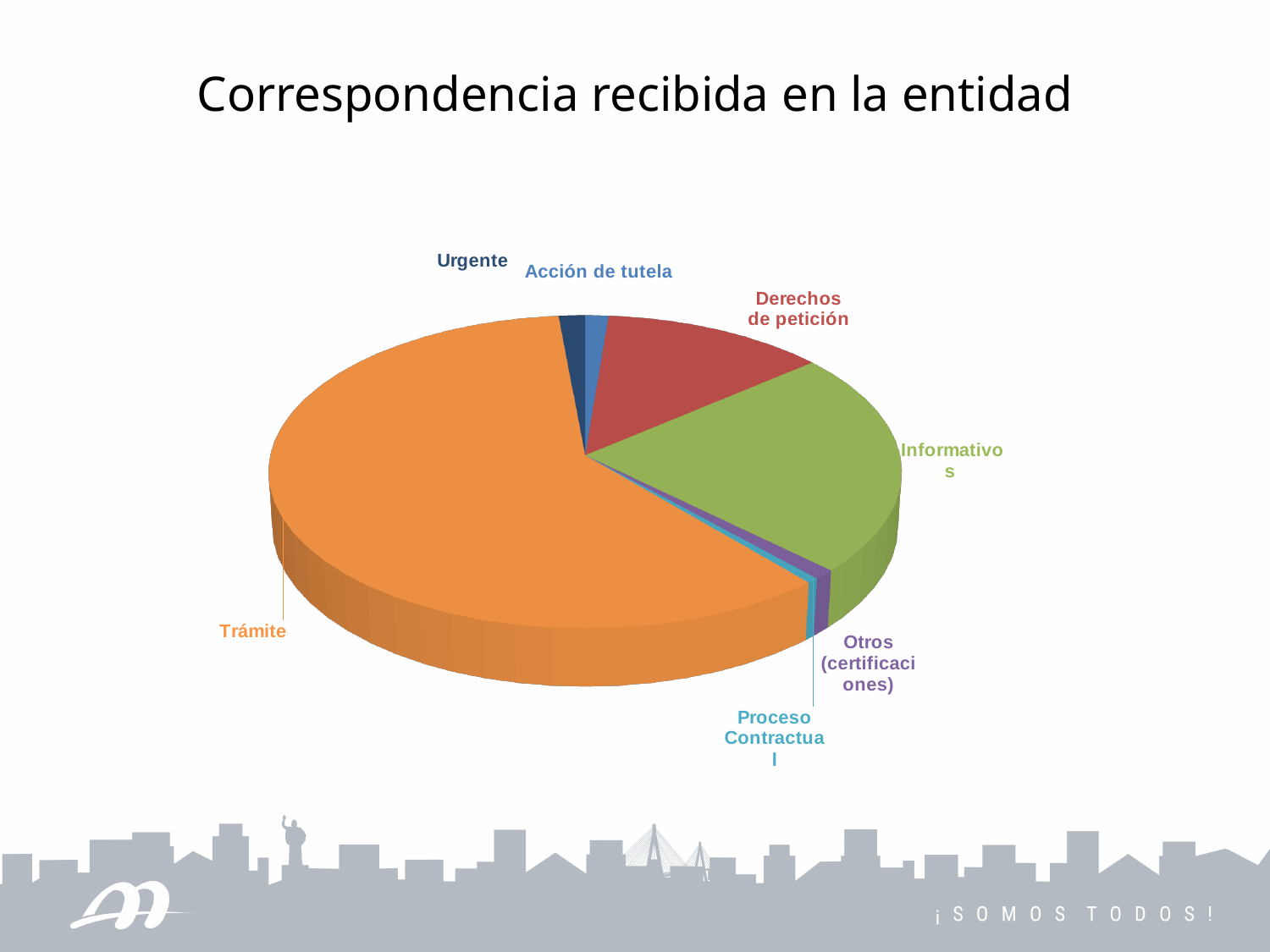
What kind of chart is shown on the slide? pie chart Which slice is larger, Trámite or Otros (certificaciones)? Trámite What is the title of the slide containing the pie chart? Correspondencia recibida en la entidad Which slice is larger, Acción de tutela or Informativos? Informativos Which slice is larger, Informativos or Derechos de petición? Informativos Which category has the largest slice of the pie? Trámite What colour is the Trámite slice of the pie chart? orange How many categories (slices) does the pie chart have? 7